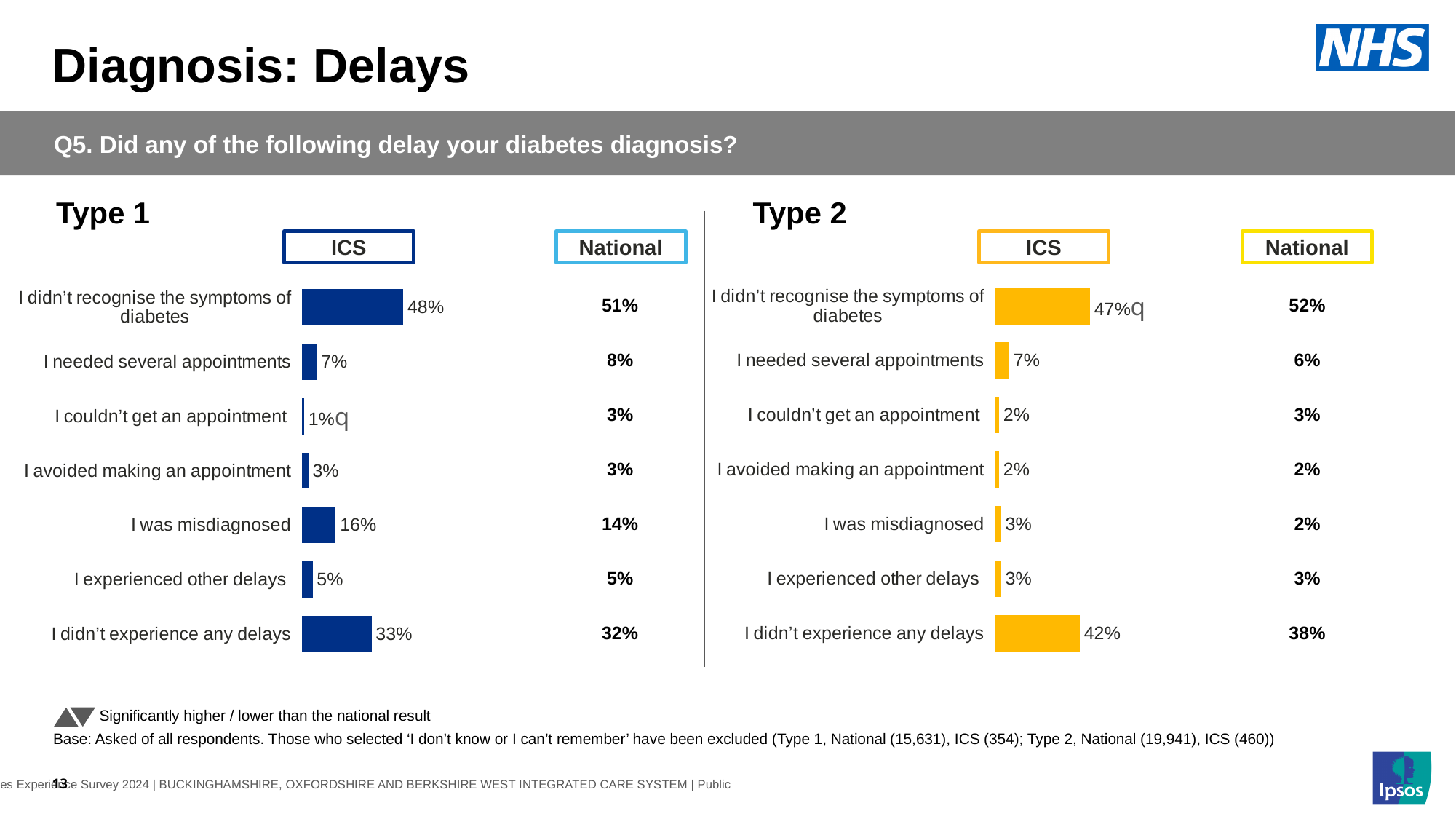
In the Type 1 chart, what is the ICS value for 'I didn't recognise the symptoms of diabetes'? 48% How many categories are shown in the Type 1 chart? 7 In the Type 1 chart, which category has the lowest ICS value? I couldn't get an appointment In the Type 2 chart, what is the National value for 'I didn't recognise the symptoms of diabetes'? 52% In the Type 2 chart, what is the difference between the ICS and National values for 'I didn't experience any delays'? 4% In the Type 1 chart, what is the difference between the ICS and National values for 'I was misdiagnosed'? 2% In the Type 2 chart, which is larger for 'I didn't recognise the symptoms of diabetes': the ICS value or the National value? National What kind of chart is used to show the ICS values in the Type 1 chart? Bar chart In the Type 1 chart, which category has the highest ICS value? I didn't recognise the symptoms of diabetes In the Type 2 chart, what is the ICS value for 'I didn't experience any delays'? 42% In the Type 1 chart, what is the ICS value for 'I was misdiagnosed'? 16% In the Type 2 chart, which category has the lowest National value? I avoided making an appointment and I was misdiagnosed